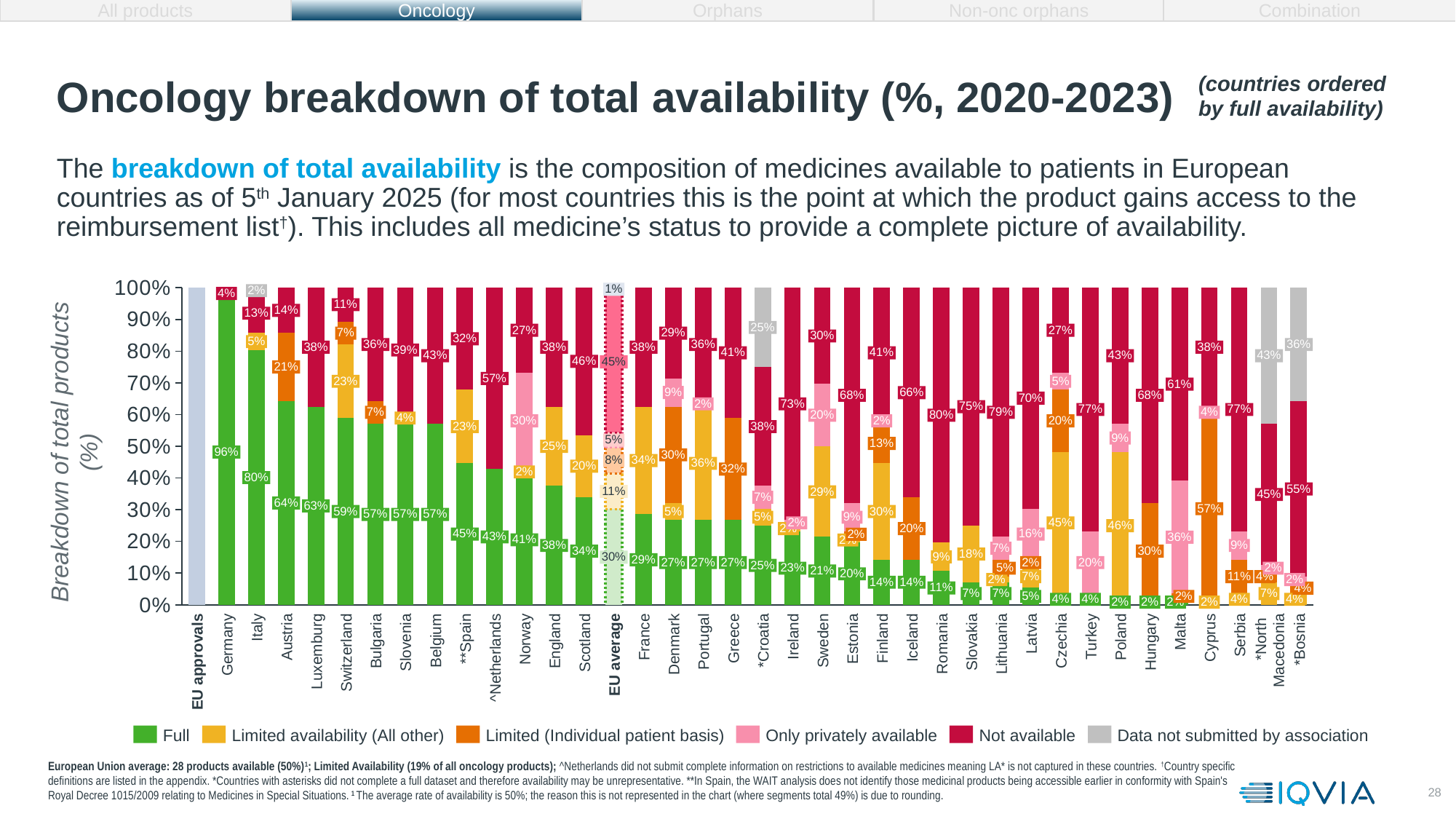
Does the Full availability share rise or fall moving from left to right across the countries? Fall What is the Full availability value for the EU average bar? 30% What is the difference between the Full availability shares of Germany and Italy? 16% What is the Data not submitted by association value for *Croatia? 25% What is the Only privately available value for Norway? 30% What kind of chart is shown on the slide? Stacked bar chart What is the Not available value for Romania? 80% Which country has the highest Full availability share? Germany Which has the larger Full availability share, Italy or Austria? Italy How many series does the legend list? 6 What is the Full availability value for Germany? 96% How many bars (categories) are shown on the x axis? 38